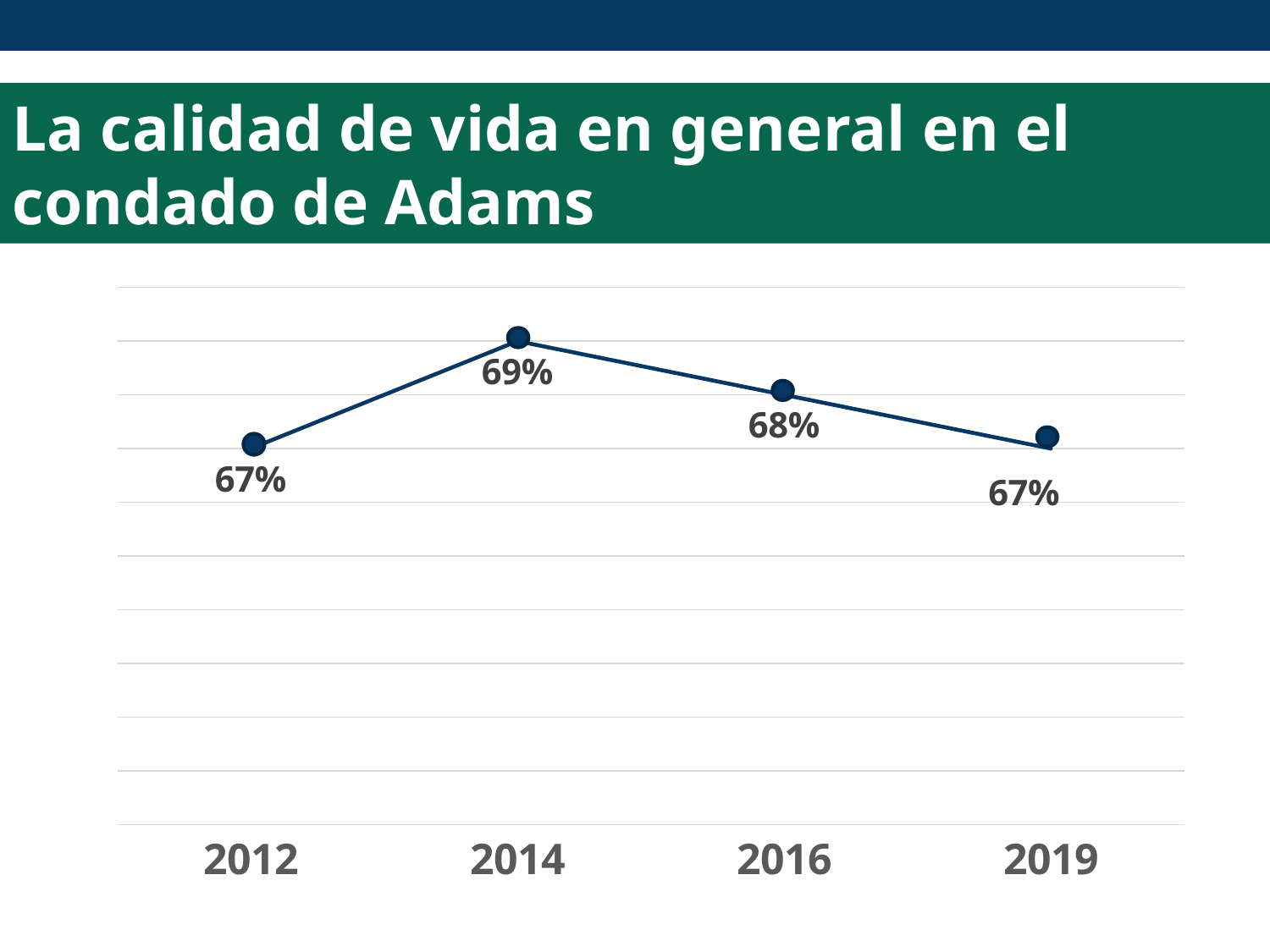
What is the difference between the values for 2014 and 2012? 2% How many data points are plotted on the chart? 4 What is the value for 2012? 67% Do the values rise or fall from 2014 to 2019? Fall What is the title of the slide? La calidad de vida en general en el condado de Adams What kind of chart is shown on the slide? Line chart What is the value for 2016? 68% What is the value for 2019? 67% Which year has the highest value? 2014 What is the difference between the values for 2016 and 2019? 1% Which is larger, the value for 2014 or the value for 2016? 2014 What is the value for 2014? 69%